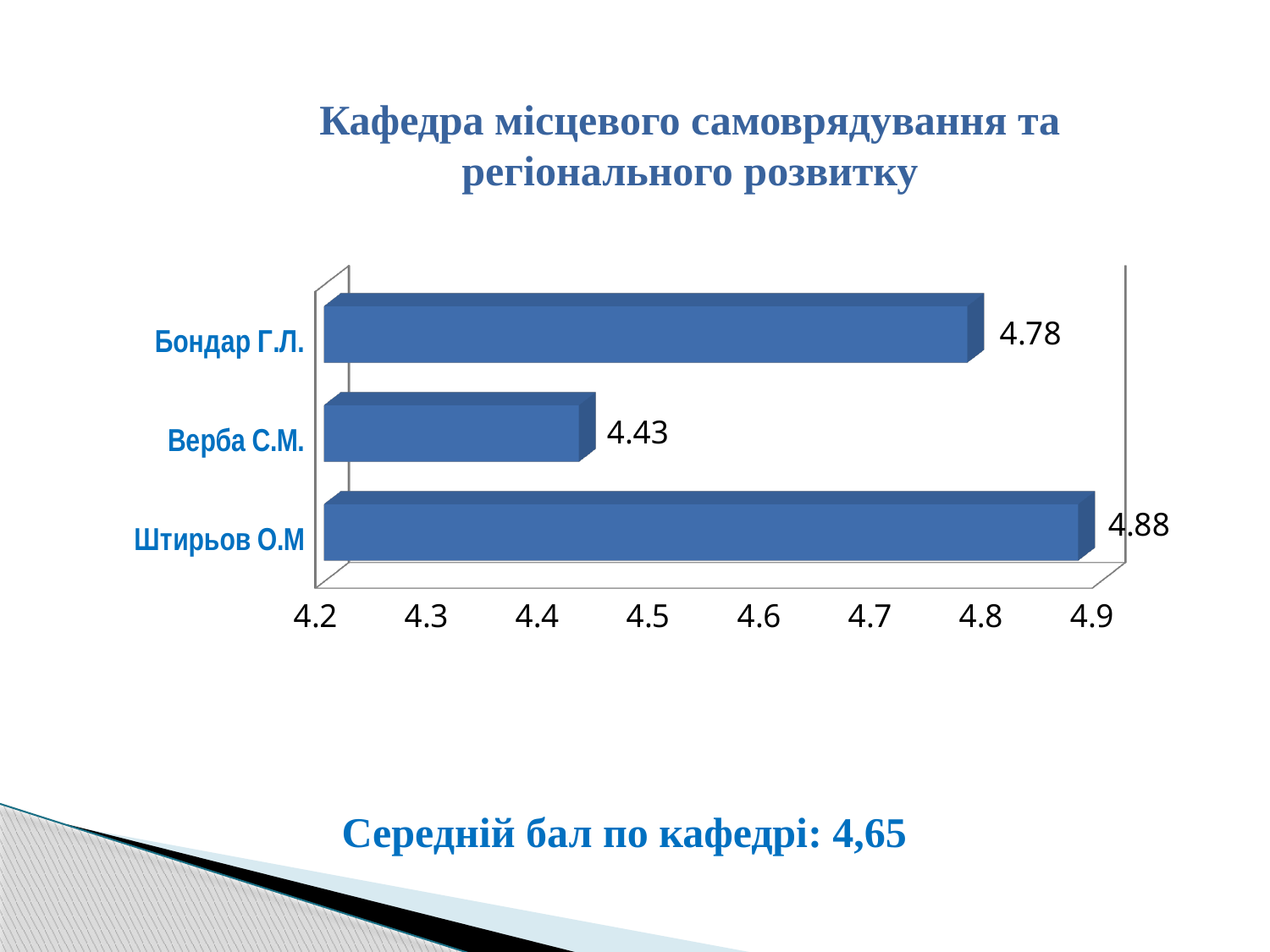
Is the value for Верба С.М. greater or less than 4.5? less What kind of chart is shown on the slide? bar chart What is the difference between the values for Штирьов О.М and Бондар Г.Л.? 0.1 What is the value for Бондар Г.Л.? 4.78 What is the value for Штирьов О.М? 4.88 What is the difference between the values for Штирьов О.М and Верба С.М.? 0.45 How many categories are shown in the chart? 3 Which category has the lowest value? Верба С.М. Which is larger, the value for Бондар Г.Л. or the value for Верба С.М.? Бондар Г.Л. What is the value for Верба С.М.? 4.43 What is the title of the chart? Кафедра місцевого самоврядування та регіонального розвитку Which category has the highest value? Штирьов О.М